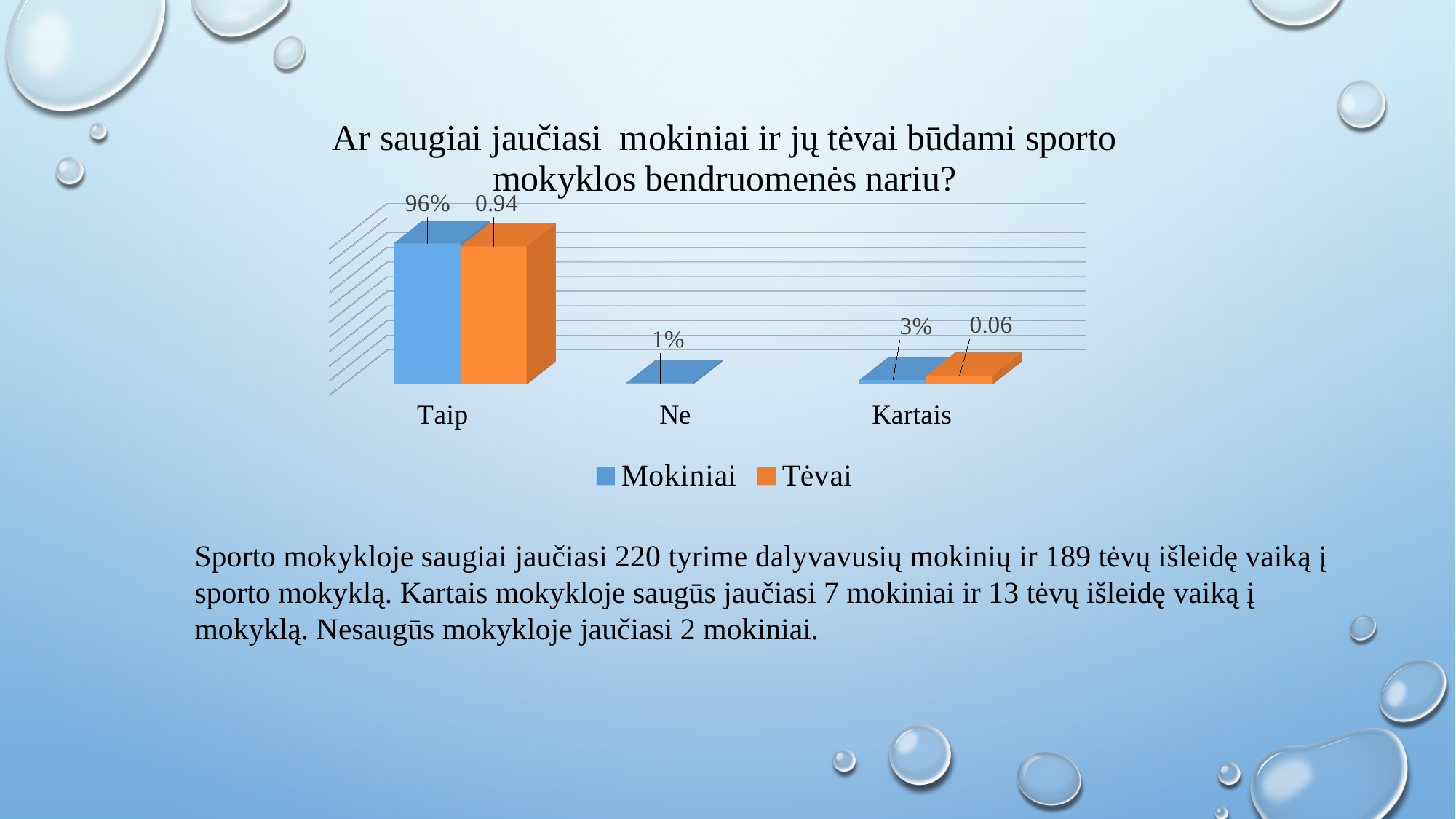
What is the value for Mokiniai in the Ne category? 1% What is the value for Mokiniai in the Taip category? 96% Which category has the highest value for Mokiniai? Taip Which is larger for Mokiniai: the value for Ne or the value for Kartais? Kartais What is the value for Tėvai in the Taip category? 0.94 What is the value for Tėvai in the Kartais category? 0.06 What is the value for Mokiniai in the Kartais category? 3% How many series does the legend list? 2 What is the difference between the Mokiniai values for Taip and Kartais? 93% Which category has the lowest value for Mokiniai? Ne What kind of chart is shown on the slide? Bar chart How many categories are shown on the x axis? 3